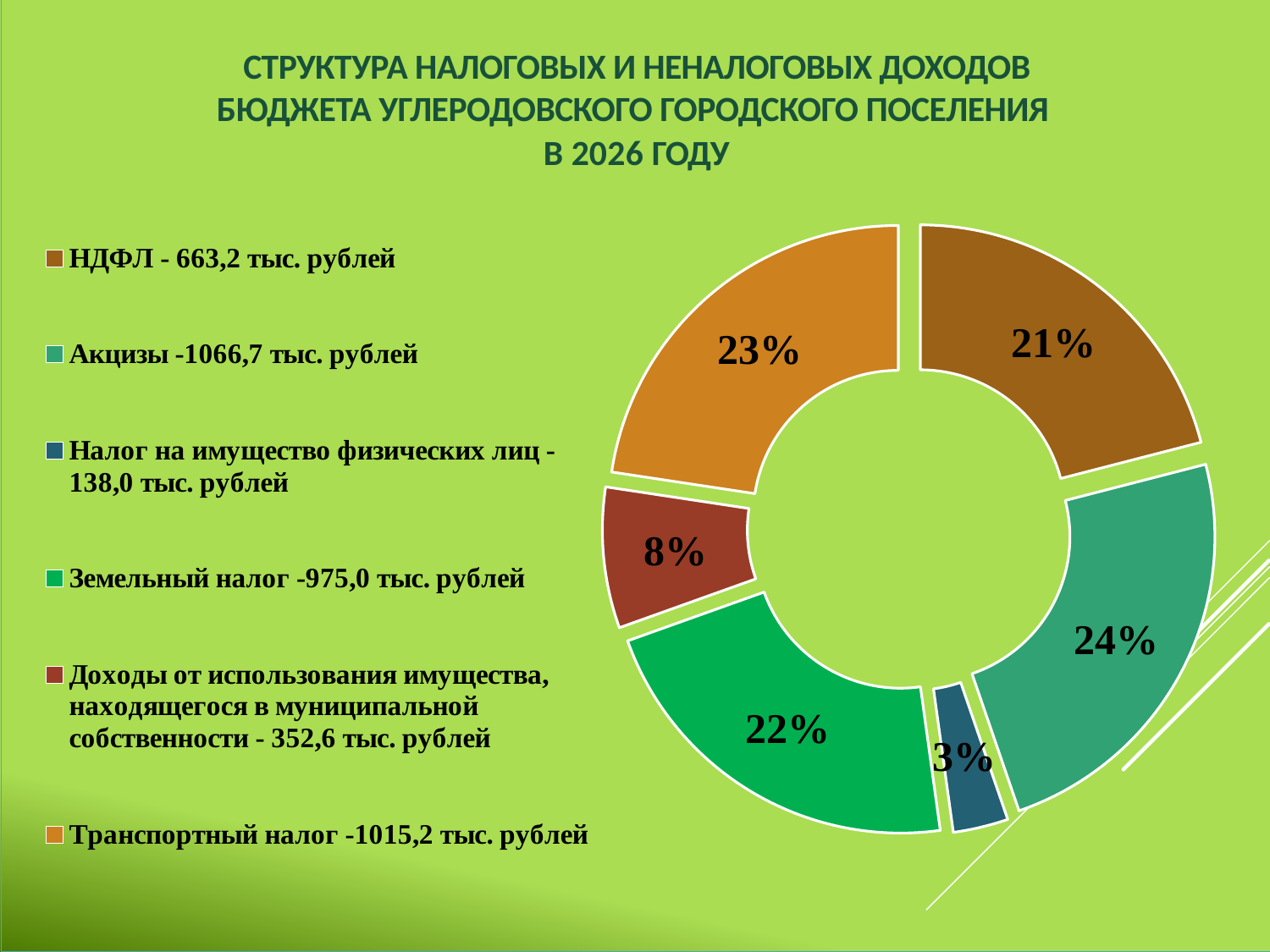
What percentage is shown for Доходы от использования имущества, находящегося в муниципальной собственности? 8% Which has the larger share: Транспортный налог or Земельный налог? Транспортный налог Which category has the largest share of the chart? Акцизы Which category has the smallest share of the chart? Налог на имущество физических лиц What percentage is shown for Транспортный налог? 23% What amount in thousand rubles does the legend give for Транспортный налог? 1015,2 тыс. рублей What is the difference in percentage points between the share of Акцизы and the share of НДФЛ? 3 What percentage is shown for Земельный налог? 22% How many categories are shown in the chart? 6 What kind of chart is shown on the slide? Pie (doughnut) chart What share of the chart does Акцизы account for? 24% What percentage is shown for НДФЛ? 21%